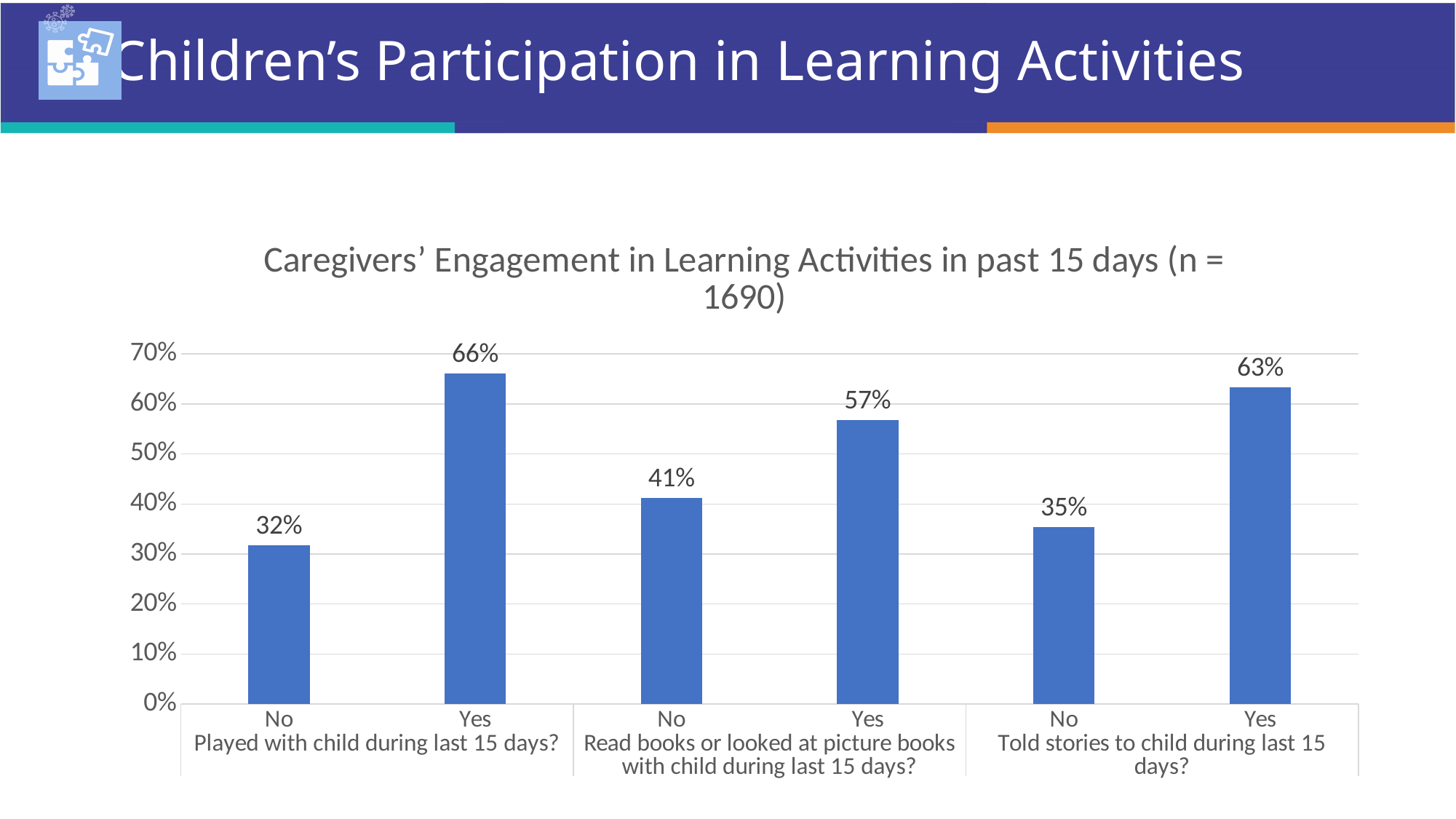
Which bar has the lowest value in the chart? No, Played with child during last 15 days? What is the difference between the Yes and No values for 'Read books or looked at picture books with child during last 15 days?' 16% How many bars are plotted in the chart? 6 What type of chart is shown on the slide? Bar chart Which is larger: the Yes value for 'Read books or looked at picture books' or the Yes value for 'Told stories to child'? Told stories to child Which bar has the highest value in the chart? Yes, Played with child during last 15 days? What percentage of caregivers answered No to 'Read books or looked at picture books with child during last 15 days?' 41% What percentage of caregivers answered Yes to 'Told stories to child during last 15 days?' 63% Is the No value for 'Told stories to child during last 15 days?' greater or less than 40%? less What is the difference between the Yes and No values for 'Told stories to child during last 15 days?' 28% What is the sample size (n) stated in the chart title? 1690 What percentage of caregivers answered Yes to 'Played with child during last 15 days?' 66%